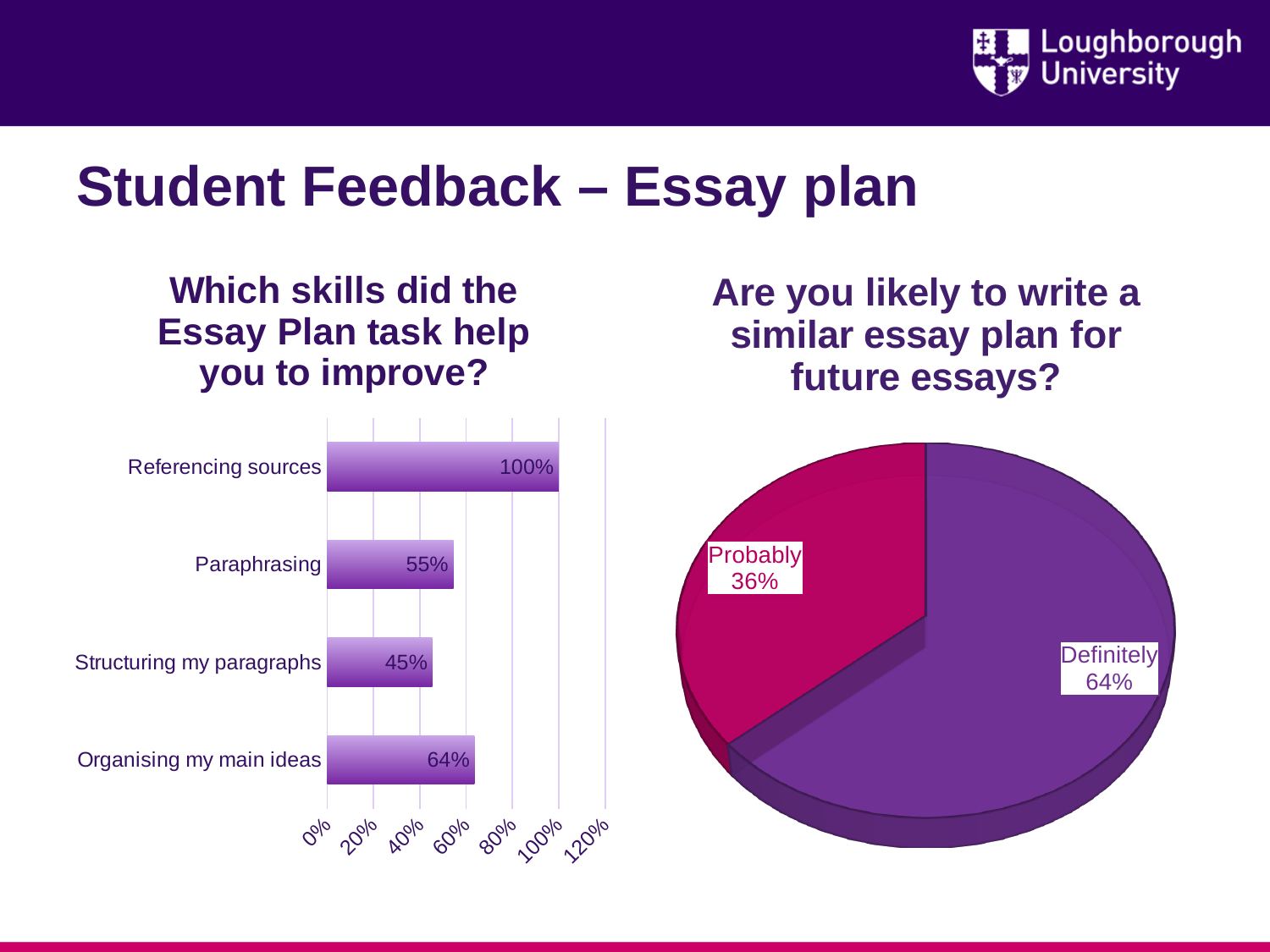
In the chart 'Which skills did the Essay Plan task help you to improve?', what is the value for Paraphrasing? 55% In the chart 'Which skills did the Essay Plan task help you to improve?', which is larger: Organising my main ideas or Structuring my paragraphs? Organising my main ideas In the chart 'Which skills did the Essay Plan task help you to improve?', how many skills are listed? 4 In the chart 'Are you likely to write a similar essay plan for future essays?', what share of the pie is Probably? 36% In the chart 'Which skills did the Essay Plan task help you to improve?', what is the difference between Referencing sources and Paraphrasing? 45% What kind of chart is 'Are you likely to write a similar essay plan for future essays?'? Pie chart In the chart 'Which skills did the Essay Plan task help you to improve?', which skill has the highest value? Referencing sources In the chart 'Which skills did the Essay Plan task help you to improve?', what is the value for Organising my main ideas? 64% In the chart 'Are you likely to write a similar essay plan for future essays?', how many slices does the pie have? 2 What kind of chart is 'Which skills did the Essay Plan task help you to improve?'? Bar chart In the chart 'Are you likely to write a similar essay plan for future essays?', which slice is the largest? Definitely In the chart 'Which skills did the Essay Plan task help you to improve?', which skill has the lowest value? Structuring my paragraphs